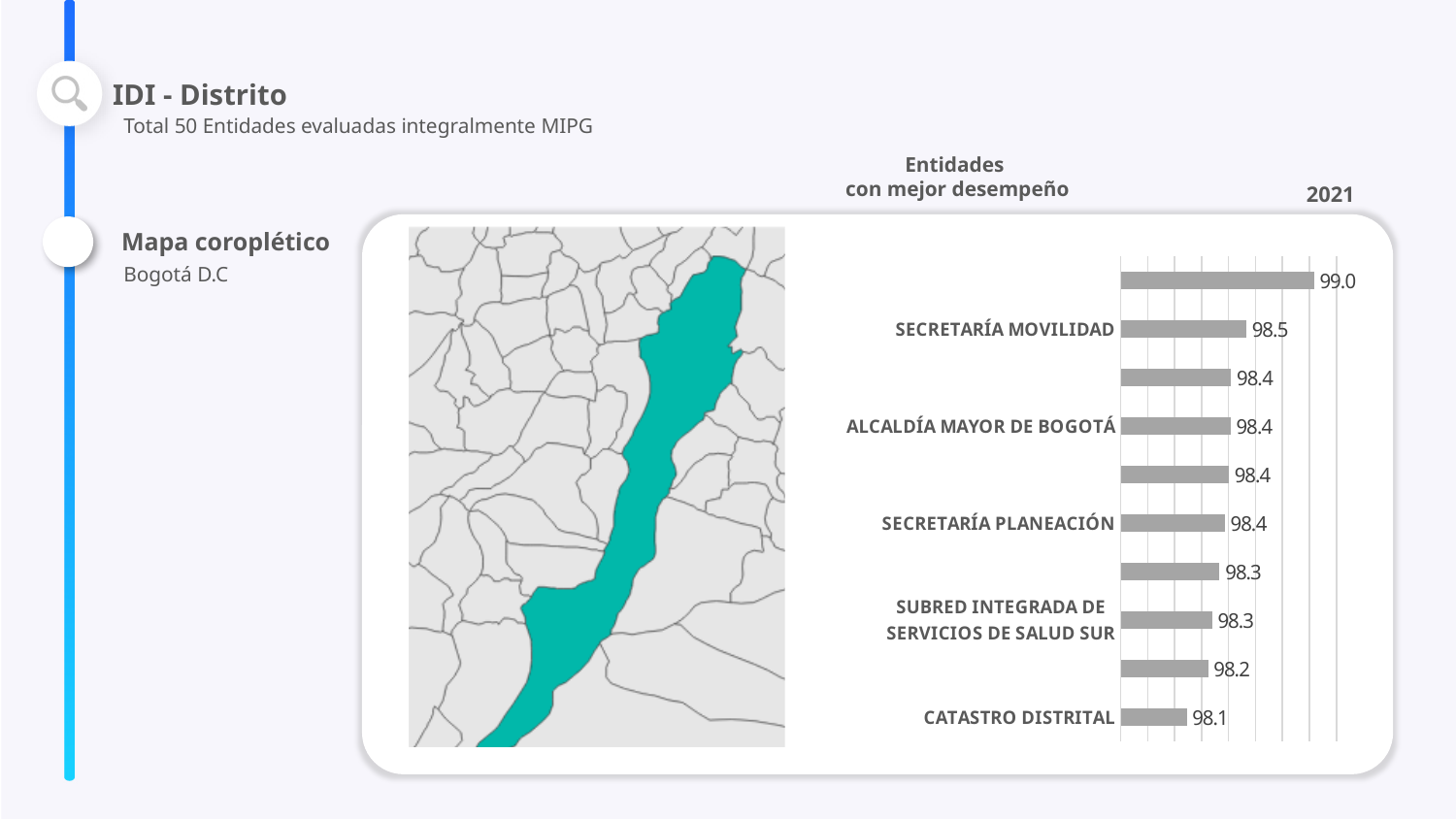
What is the highest value shown in the bar chart? 99.0 What is the value for SECRETARÍA PLANEACIÓN? 98.4 What type of chart is shown on the right side of the slide? bar chart What is the value for SUBRED INTEGRADA DE SERVICIOS DE SALUD SUR? 98.3 How many bars are plotted in the bar chart? 10 What year is indicated above the bar chart? 2021 What is the value for SECRETARÍA MOVILIDAD? 98.5 Which labeled entity has the lowest value in the bar chart? CATASTRO DISTRITAL What is the value for CATASTRO DISTRITAL? 98.1 What is the difference between the values for SECRETARÍA MOVILIDAD and CATASTRO DISTRITAL? 0.4 What is the value for ALCALDÍA MAYOR DE BOGOTÁ? 98.4 Which is larger, the value for SECRETARÍA MOVILIDAD or the value for SECRETARÍA PLANEACIÓN? SECRETARÍA MOVILIDAD